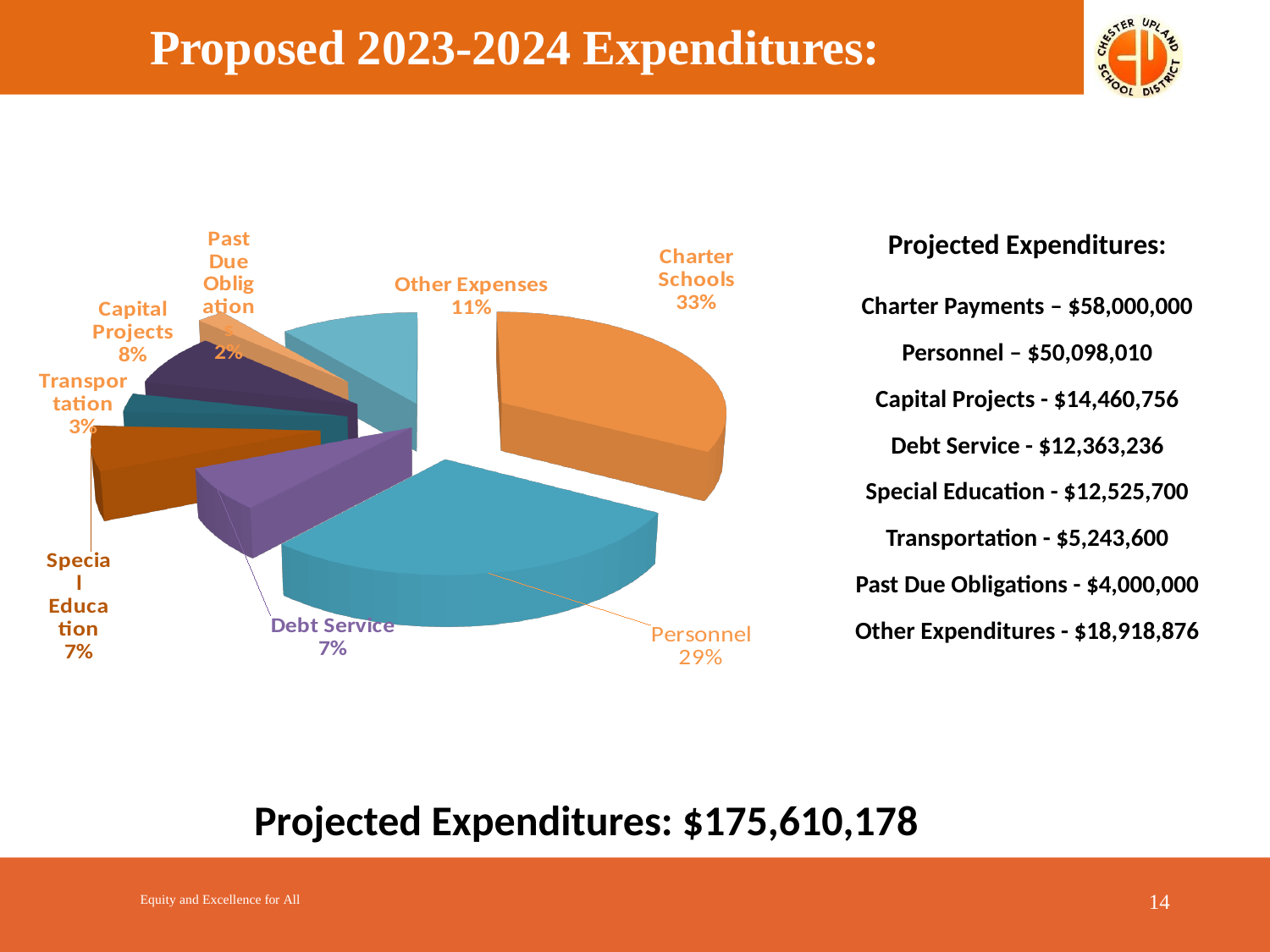
What percentage is shown for Capital Projects? 8% How many slices does the pie chart have? 8 What share of the pie does Personnel represent? 29% What percentage is shown for Other Expenses? 11% What percentage is shown for Transportation? 3% Which is larger, the share for Personnel or the share for Other Expenses? Personnel Which category has the largest slice of the pie? Charter Schools Which category has the smallest slice of the pie? Past Due Obligations What is the title of the slide containing the pie chart? Proposed 2023-2024 Expenditures: What kind of chart is shown on the slide? pie chart What is the difference in percentage points between Charter Schools and Personnel? 4 What share of the pie does Charter Schools represent? 33%